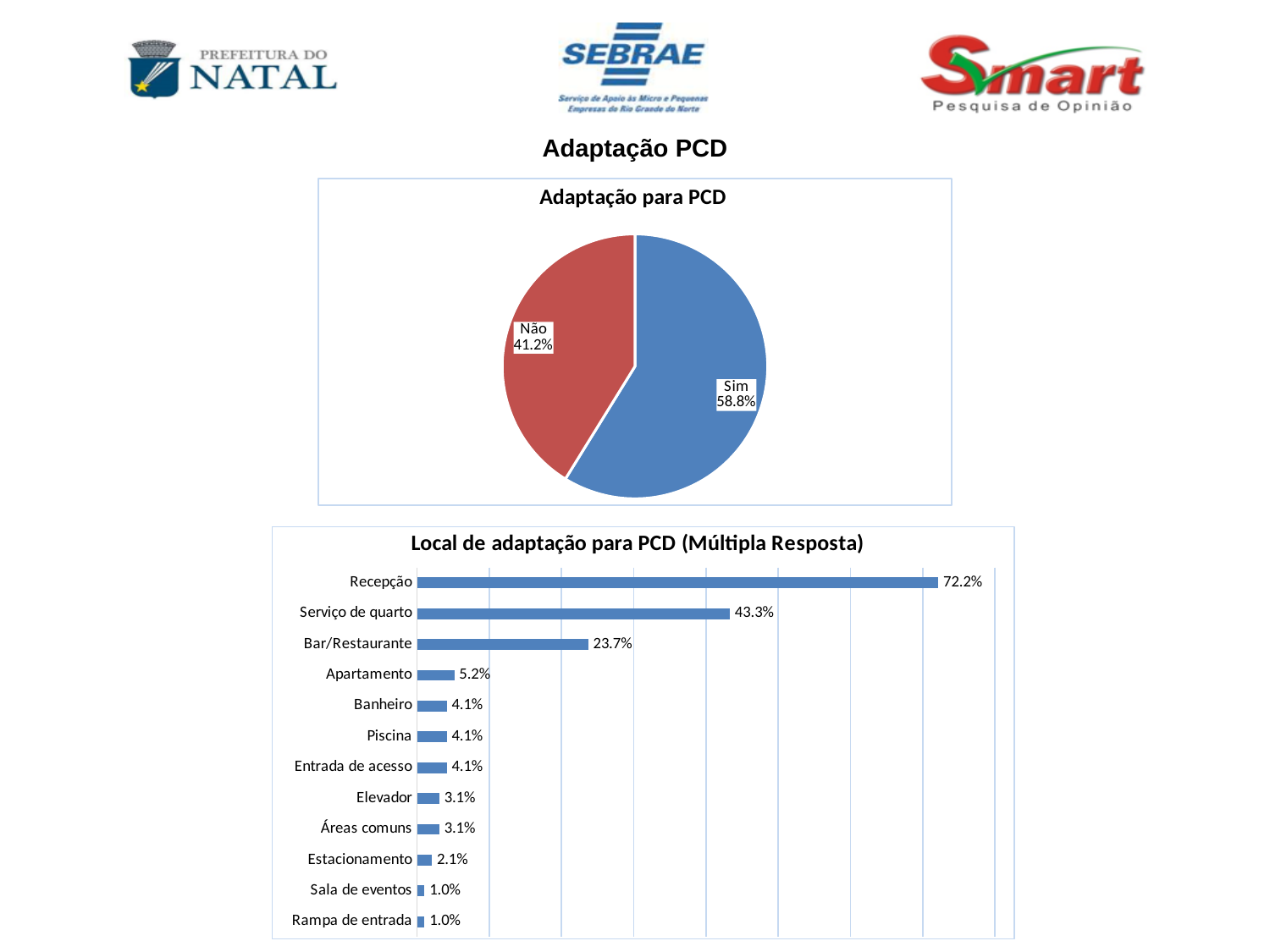
In the 'Local de adaptação para PCD (Múltipla Resposta)' chart, which category has the highest value? Recepção In the 'Local de adaptação para PCD (Múltipla Resposta)' chart, which is larger, 'Apartamento' or 'Estacionamento'? Apartamento In the 'Adaptação para PCD' pie chart, which slice is larger, 'Sim' or 'Não'? Sim In the 'Local de adaptação para PCD (Múltipla Resposta)' chart, what is the value for 'Bar/Restaurante'? 23.7% In the 'Local de adaptação para PCD (Múltipla Resposta)' chart, what is the difference between 'Recepção' and 'Serviço de quarto'? 28.9% What kind of chart is 'Adaptação para PCD'? Pie chart In the 'Local de adaptação para PCD (Múltipla Resposta)' chart, how many categories are shown? 12 What kind of chart is 'Local de adaptação para PCD (Múltipla Resposta)'? Bar chart In the 'Local de adaptação para PCD (Múltipla Resposta)' chart, what is the value for 'Elevador'? 3.1% In the 'Adaptação para PCD' pie chart, what share is labelled 'Sim'? 58.8% In the 'Adaptação para PCD' pie chart, what share is labelled 'Não'? 41.2% In the 'Local de adaptação para PCD (Múltipla Resposta)' chart, what is the value for 'Recepção'? 72.2%